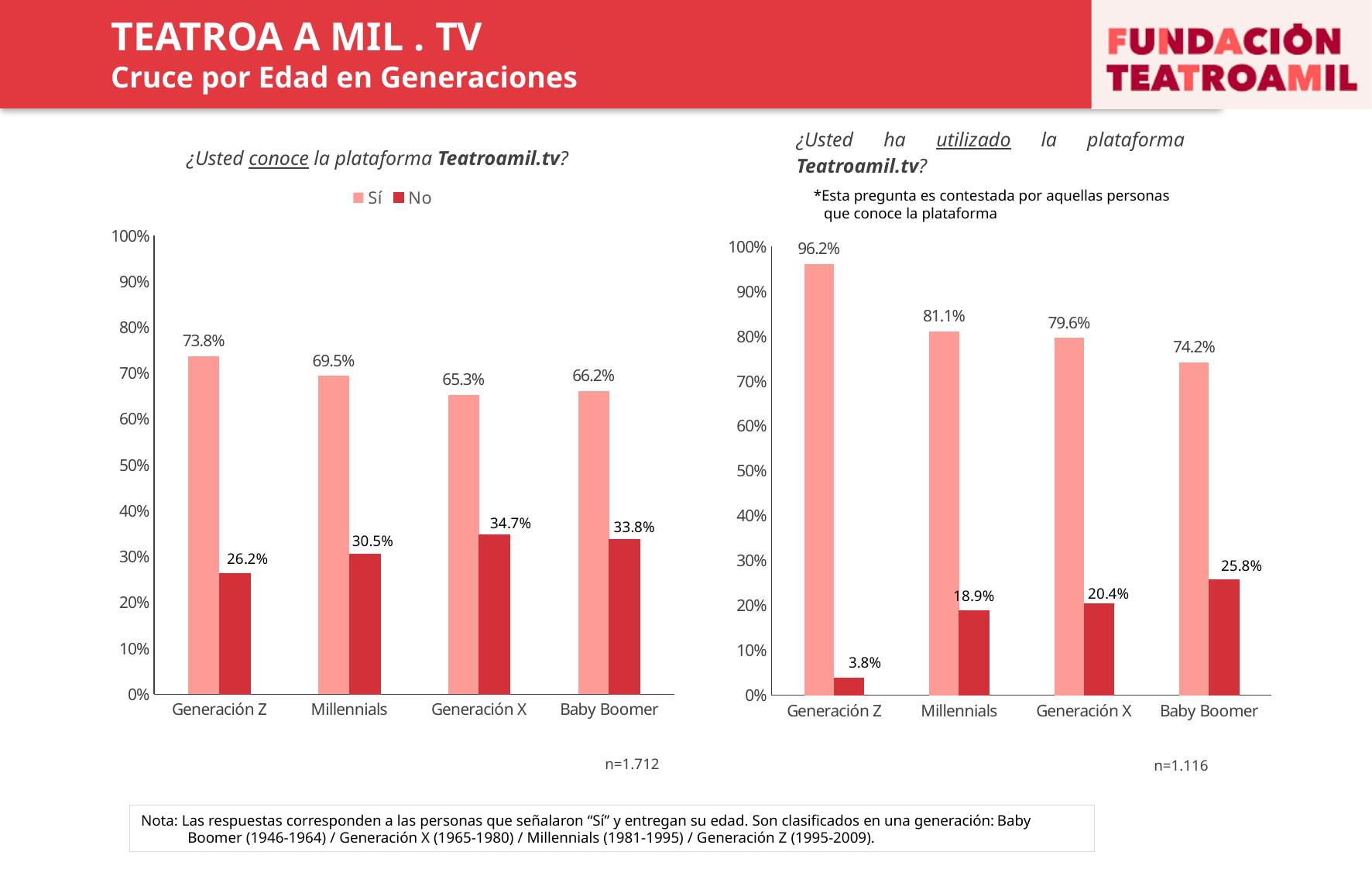
In the left chart (¿Usted conoce la plataforma Teatroamil.tv?), which is larger: the No value for Millennials or the No value for Baby Boomer? Baby Boomer In the right chart (¿Usted ha utilizado la plataforma Teatroamil.tv?), what is the difference between the Sí values for Generación Z and Baby Boomer? 22.0 percentage points How many series does the legend of the left chart (¿Usted conoce la plataforma Teatroamil.tv?) list? 2 In the right chart (¿Usted ha utilizado la plataforma Teatroamil.tv?), what is the Sí value for Millennials? 81.1% In the left chart (¿Usted conoce la plataforma Teatroamil.tv?), what is the Sí value for Generación Z? 73.8% In the right chart (¿Usted ha utilizado la plataforma Teatroamil.tv?), which generation has the lowest No value? Generación Z What kind of chart is the right chart (¿Usted ha utilizado la plataforma Teatroamil.tv?)? Bar chart In the right chart (¿Usted ha utilizado la plataforma Teatroamil.tv?), is the Sí value for Generación X greater or less than 70%? greater How many generation categories are shown on the x axis of the left chart (¿Usted conoce la plataforma Teatroamil.tv?)? 4 In the left chart (¿Usted conoce la plataforma Teatroamil.tv?), what is the No value for Generación X? 34.7% In the left chart (¿Usted conoce la plataforma Teatroamil.tv?), which generation has the highest Sí value? Generación Z In the right chart (¿Usted ha utilizado la plataforma Teatroamil.tv?), what is the No value for Baby Boomer? 25.8%